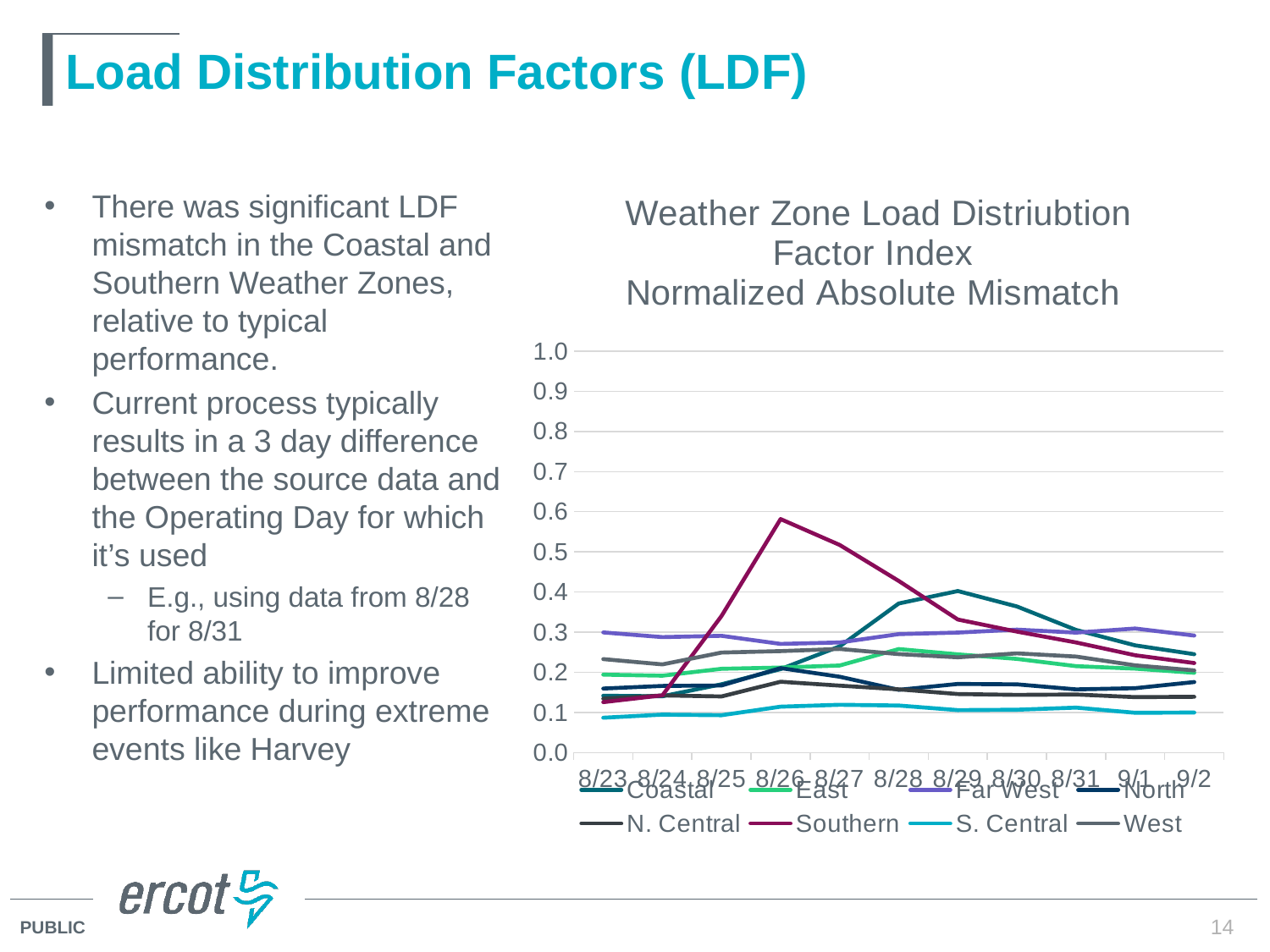
Which series reaches the highest value anywhere on the chart? Southern On which date does the Southern series reach its peak? 8/26 Is the value for Southern on 8/26 greater or less than 0.5? greater How many series does the legend list? 8 What kind of chart is shown on the slide? line chart Does the Southern series rise or fall from 8/26 to 9/2? fall Is the value for Southern on 8/23 greater or less than 0.2? less Is the value for Coastal on 8/29 greater or less than 0.3? greater Which series stays lowest across the chart? S. Central On 8/26, which is larger: the Southern value or the Coastal value? Southern What is the title of the chart? Weather Zone Load Distriubtion Factor Index Normalized Absolute Mismatch How many dates are shown along the x axis? 11